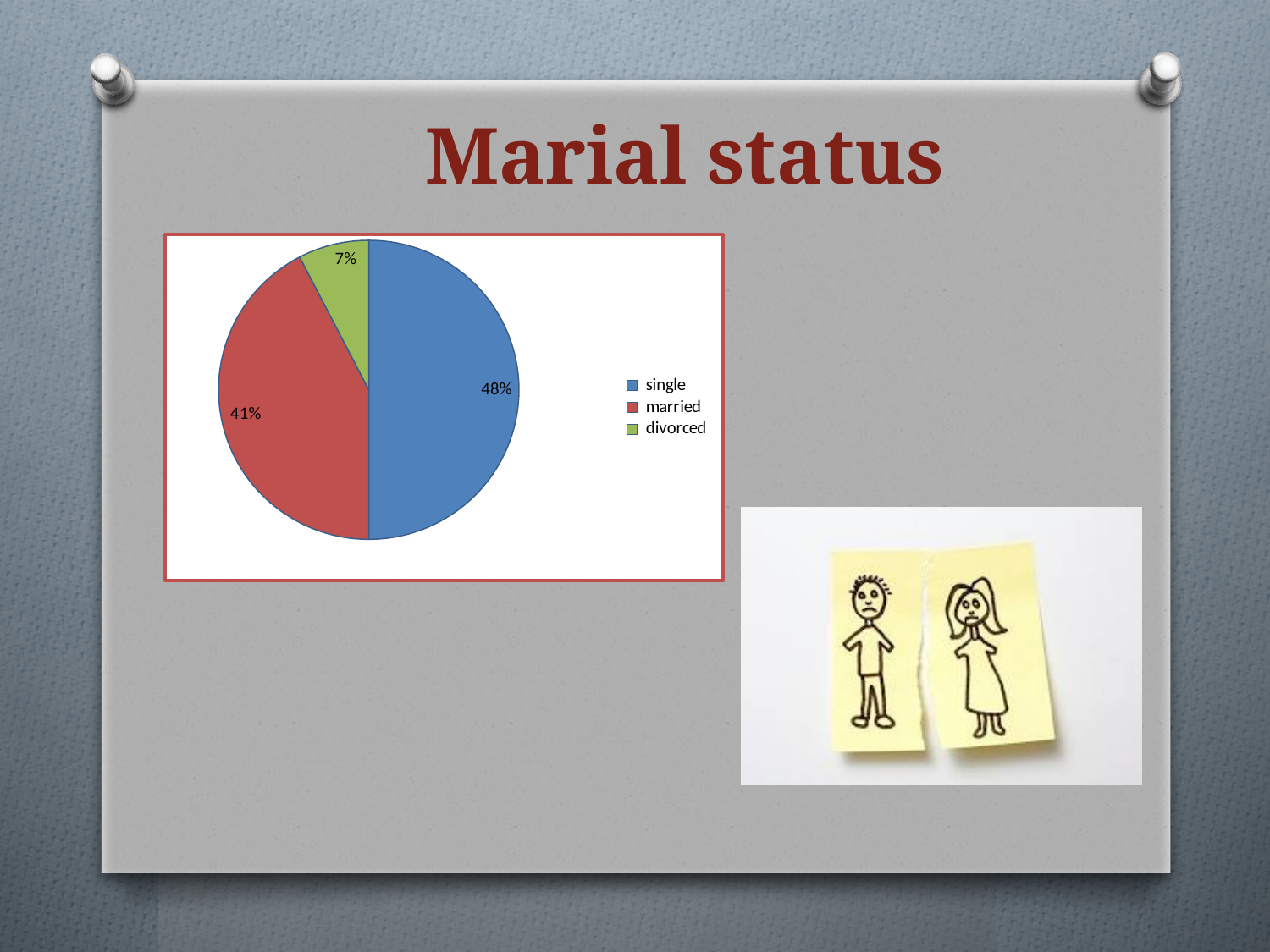
Which category has the largest slice of the pie? single What percentage of the pie is labelled married? 41% Which category has the smallest slice of the pie? divorced What type of chart is shown on the slide? pie chart What is the difference in percentage points between the single and married slices? 7 What is the title of the slide containing the pie chart? Marial status How many categories does the pie chart show? 3 What percentage of the pie is labelled single? 48% What is the difference in percentage points between the married and divorced slices? 34 What percentage of the pie is labelled divorced? 7% What colour is the slice for married? red Which slice is larger, married or divorced? married